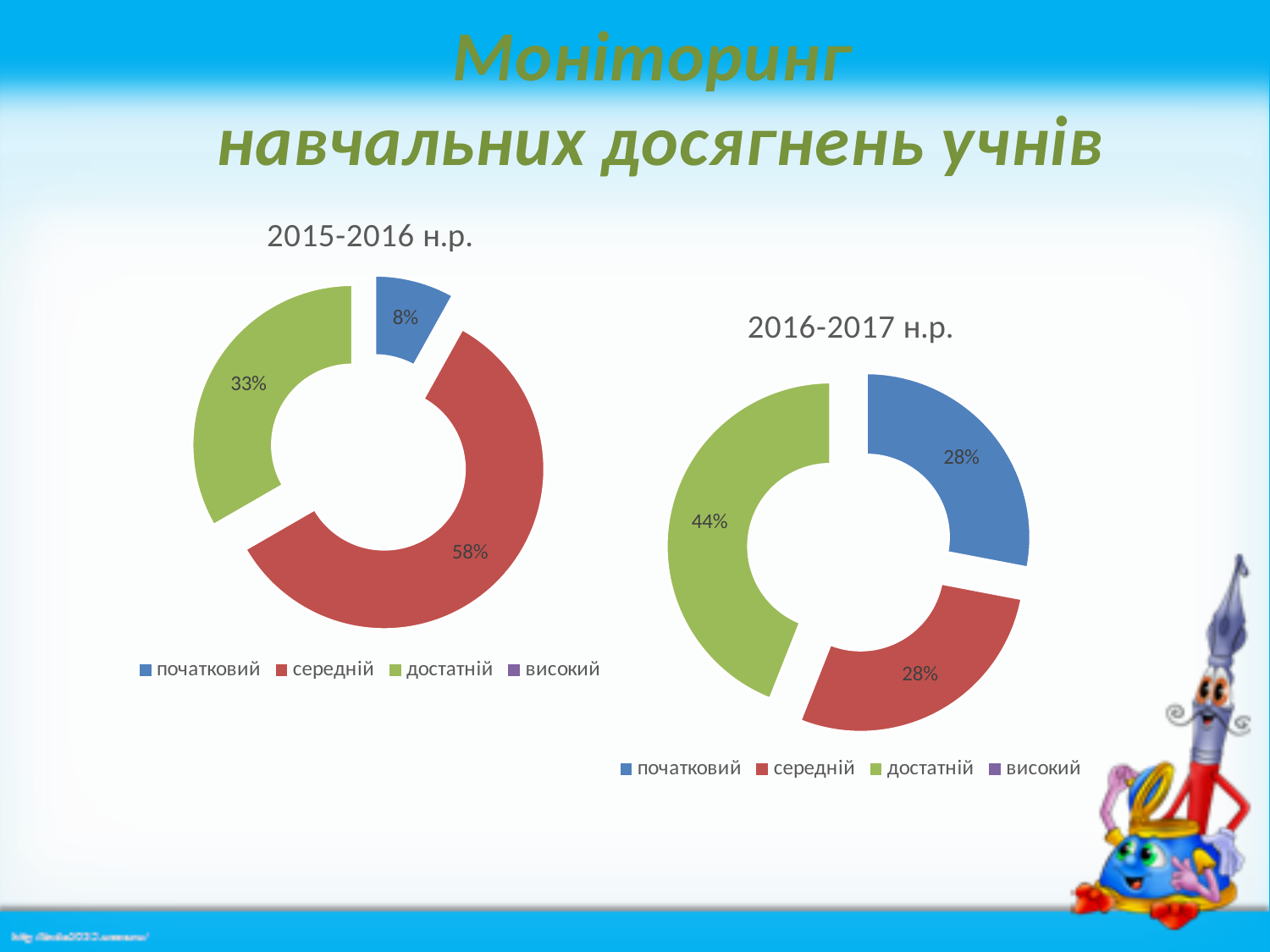
In the 2016-2017 н.р. chart, what percentage is shown for достатній? 44% In the 2015-2016 н.р. chart, what is the difference between the середній and достатній shares? 25% In the 2015-2016 н.р. chart, which labelled category has the smallest share? початковий In the 2015-2016 н.р. chart, what percentage is shown for середній? 58% In the 2016-2017 н.р. chart, which category has the largest share? достатній What type of chart is the 2015-2016 н.р. chart? Doughnut chart How many entries does the legend of the 2016-2017 н.р. chart list? 4 In the 2016-2017 н.р. chart, what percentage is shown for початковий? 28% In the 2015-2016 н.р. chart, which category has the largest share? середній In the 2016-2017 н.р. chart, what is the difference between the достатній and середній shares? 16% Which is larger: the початковий share in the 2015-2016 н.р. chart or the початковий share in the 2016-2017 н.р. chart? 2016-2017 н.р. In the 2015-2016 н.р. chart, what percentage is shown for початковий? 8%